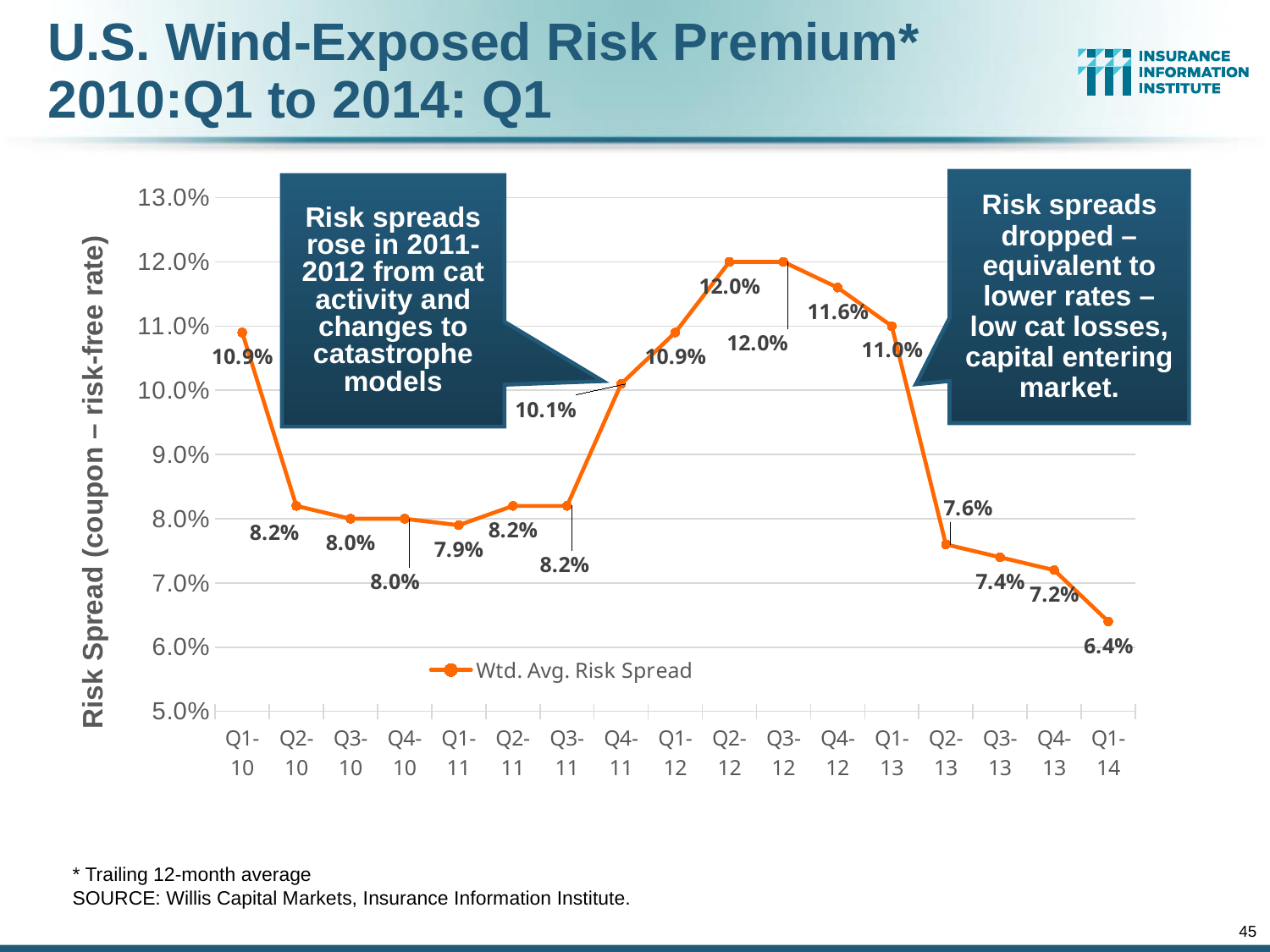
What is the highest weighted average risk spread value shown on the chart? 12.0% How many quarters are plotted on the x axis? 17 What is the weighted average risk spread for Q4-11? 10.1% Do the values rise or fall from Q1-13 to Q1-14? Fall Which is larger, the risk spread in Q4-12 or in Q1-12? Q4-12 What is the weighted average risk spread for Q1-14? 6.4% What is the weighted average risk spread for Q2-13? 7.6% What kind of chart is shown on the slide? Line chart How many series does the legend list? 1 Which quarter has the lowest weighted average risk spread? Q1-14 What is the weighted average risk spread for Q1-10? 10.9% What is the difference between the risk spread in Q1-13 and Q2-13? 3.4%